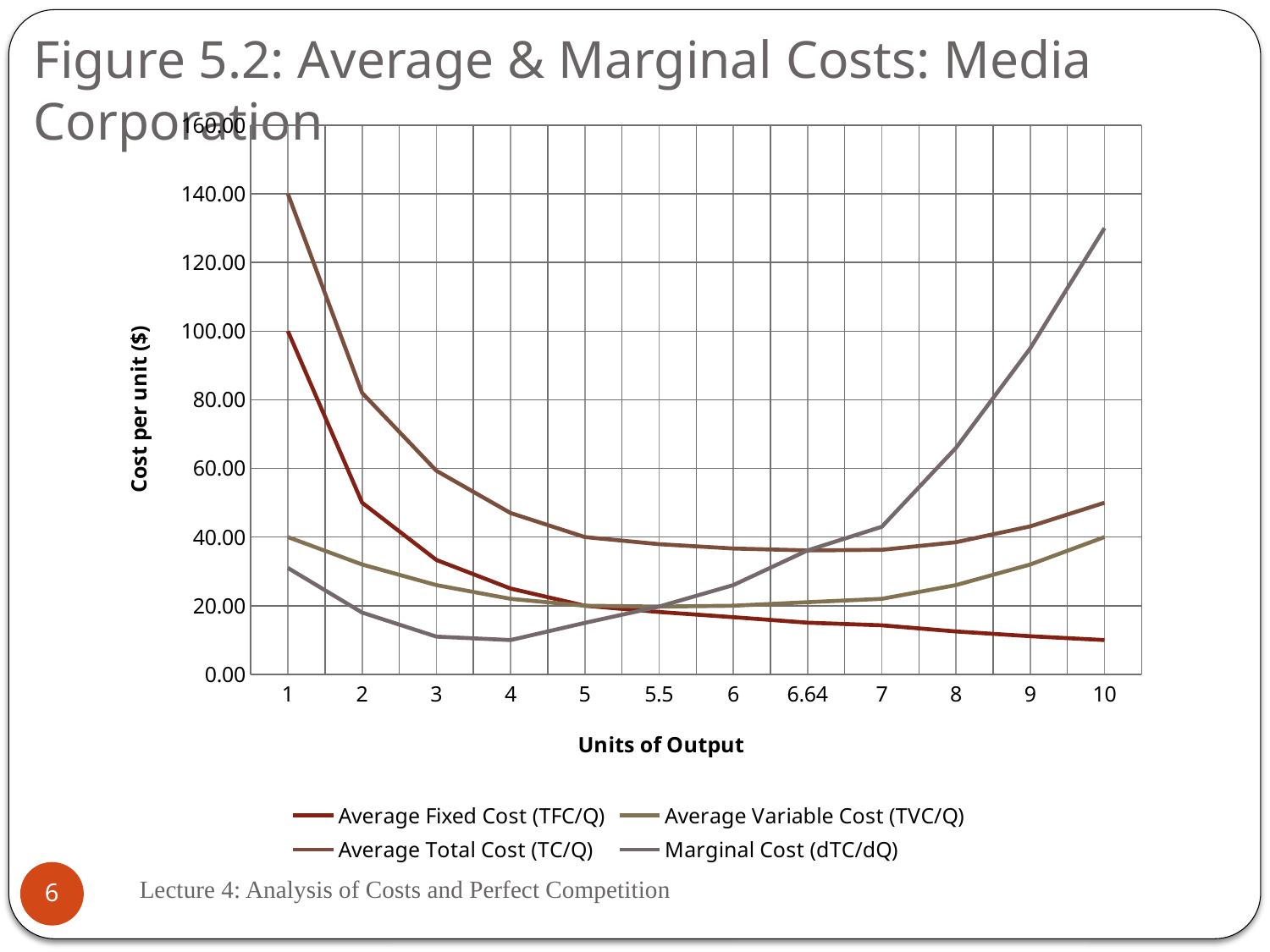
At 10 units of output, which is larger: Marginal Cost (dTC/dQ) or Average Total Cost (TC/Q)? Marginal Cost (dTC/dQ) What is the Average Variable Cost (TVC/Q) at 1 unit of output? 40.00 Is the Marginal Cost (dTC/dQ) at 4 units of output greater or less than 20? less How many units-of-output categories are shown on the x axis? 12 Is the Average Fixed Cost (TFC/Q) at 10 units of output greater or less than 20? less Which series has the highest value at 1 unit of output? Average Total Cost (TC/Q) Is the Marginal Cost (dTC/dQ) at 10 units of output greater or less than 120? greater Does the Average Fixed Cost (TFC/Q) rise or fall as units of output increase? fall How many series does the legend list? 4 What is the Average Fixed Cost (TFC/Q) at 1 unit of output? 100.00 What is the Average Total Cost (TC/Q) at 1 unit of output? 140.00 What kind of chart is shown on the slide? line chart